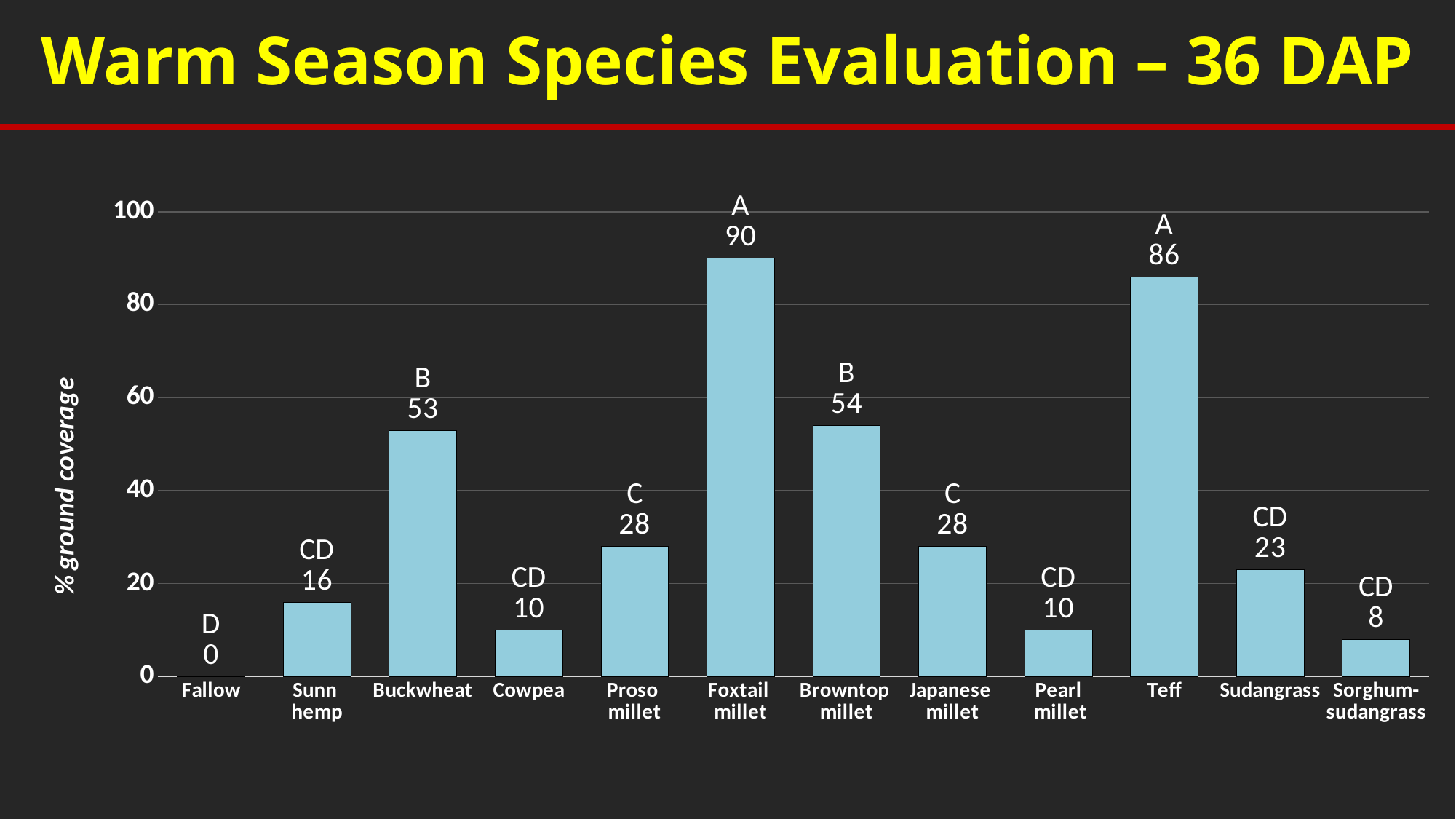
What statistical grouping letter is shown above the Teff bar? A What is the difference in % ground coverage between Foxtail millet and Teff? 4 Which category has the lowest % ground coverage? Fallow What kind of chart is shown on the slide? bar chart What is the difference in % ground coverage between Browntop millet and Sorghum-sudangrass? 46 What is the % ground coverage value for Sudangrass? 23 Which has a higher % ground coverage, Buckwheat or Proso millet? Buckwheat Is the value for Sunn hemp greater or less than 20? less What is the % ground coverage value for Foxtail millet? 90 Which species has the highest % ground coverage? Foxtail millet What is the % ground coverage value for Buckwheat? 53 How many categories are shown on the x axis? 12